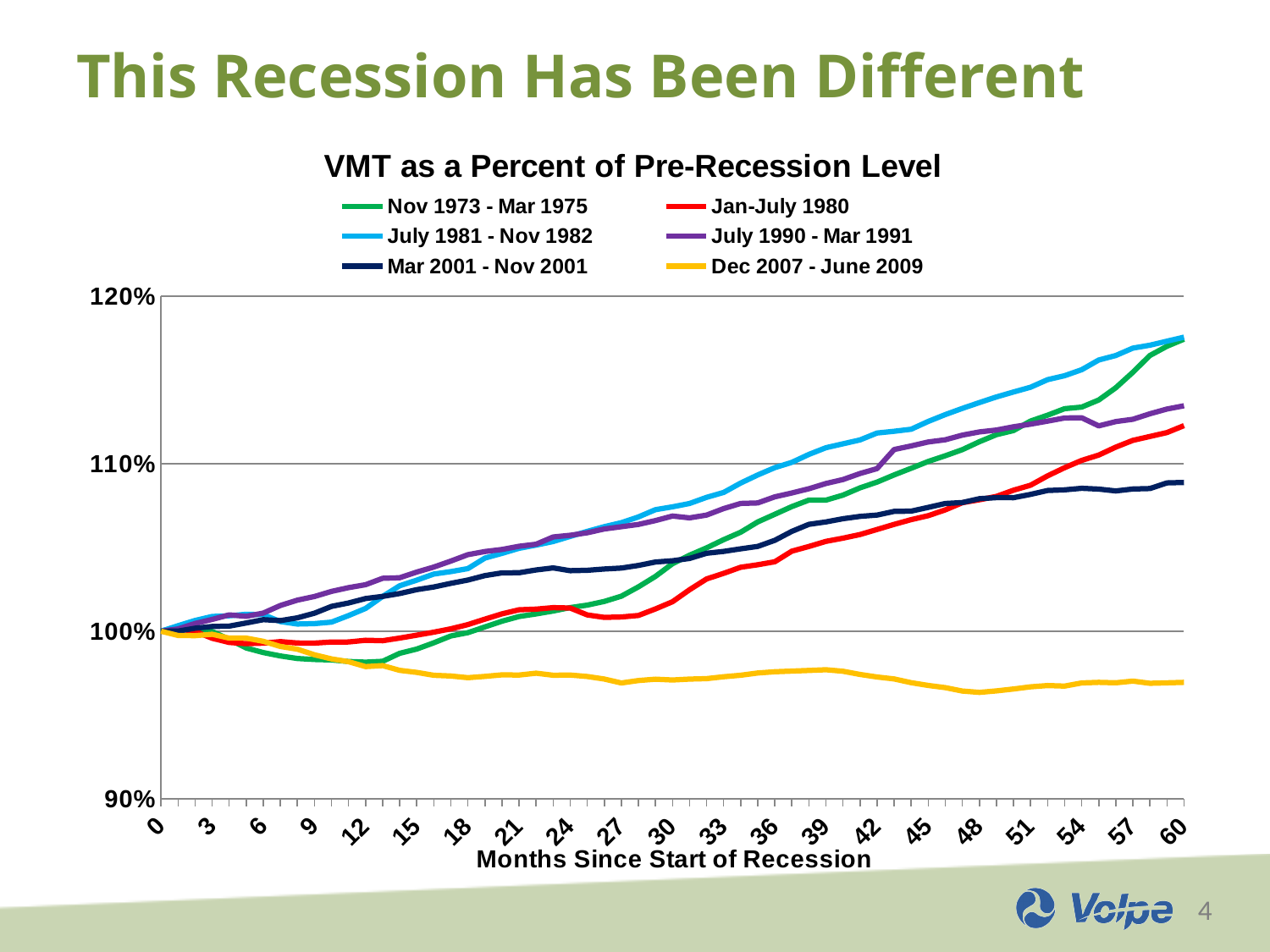
Is the value for Dec 2007 - June 2009 at month 60 greater or less than 100%? less What kind of chart is shown on the slide? line chart At month 60, which is larger: the value for Jan-July 1980 or the value for Mar 2001 - Nov 2001? Jan-July 1980 Does the Dec 2007 - June 2009 line rise or fall overall from month 0 to month 60? fall How many series does the legend list? 6 Is the value for Mar 2001 - Nov 2001 at month 60 greater or less than 110%? less Does the July 1981 - Nov 1982 line rise or fall overall from month 0 to month 60? rise Which series has the lowest value at month 48? Dec 2007 - June 2009 Is the value for July 1981 - Nov 1982 at month 60 greater or less than 110%? greater What is the title of the chart? VMT as a Percent of Pre-Recession Level At month 24, which is larger: the value for Mar 2001 - Nov 2001 or the value for Jan-July 1980? Mar 2001 - Nov 2001 What is the label of the x axis? Months Since Start of Recession